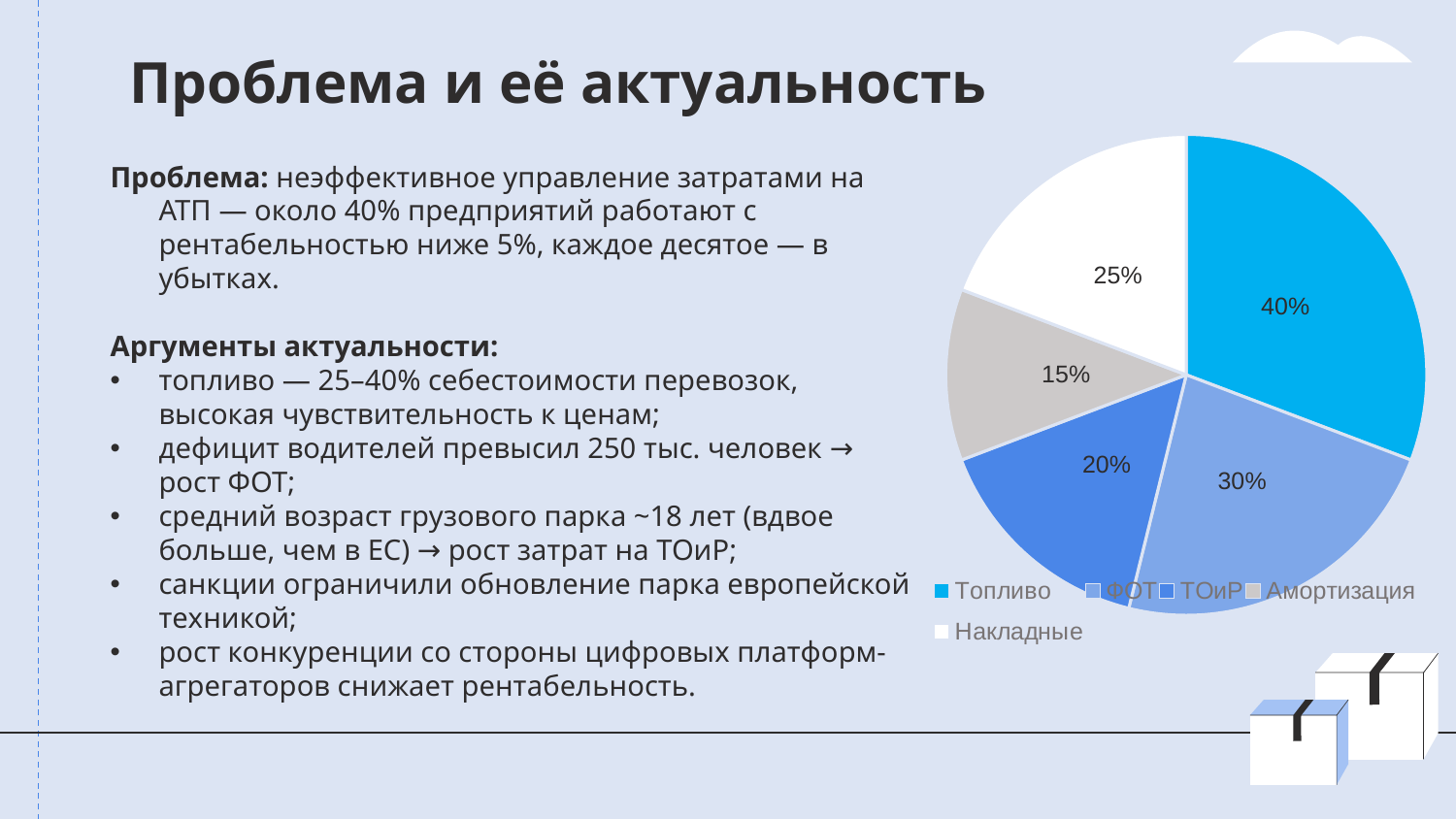
How many entries does the legend list? 5 What percentage is shown for the ФОТ slice? 30% What percentage is shown for the Амортизация slice? 15% Which category has the largest slice of the pie? Топливо What percentage is shown for the Накладные slice? 25% What kind of chart is shown on the slide? pie chart What percentage is shown for the ТОиР slice? 20% What is the difference between the Топливо and ФОТ percentages? 10% Which is larger, the Накладные slice or the ТОиР slice? Накладные What percentage is shown for the Топливо slice? 40% Which category has the smallest slice of the pie? Амортизация How many slices does the pie chart have? 5